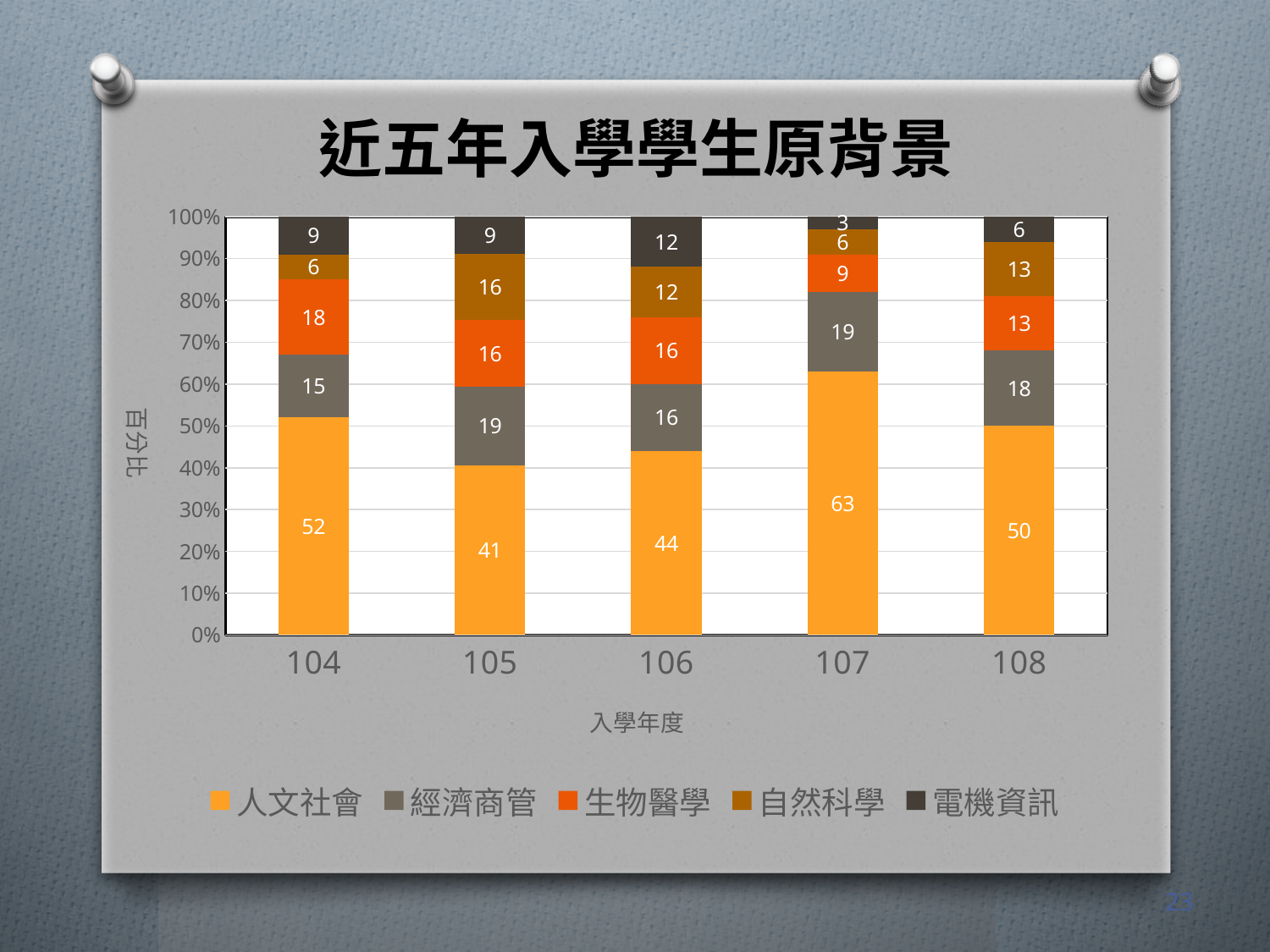
What is the value for 經濟商管 in 105? 19 What is the difference between the 人文社會 values for 107 and 105? 22 What is the value for 電機資訊 in 106? 12 In which year is the 人文社會 value highest? 107 How many series does the legend list? 5 In which year is the 電機資訊 value lowest? 107 What is the title of the chart? 近五年入學學生原背景 What is the value for 人文社會 in 107? 63 Which is larger, the 生物醫學 value for 104 or for 108? 104 What kind of chart is shown on the slide? stacked bar chart What is the value for 自然科學 in 108? 13 How many years are shown on the x axis? 5